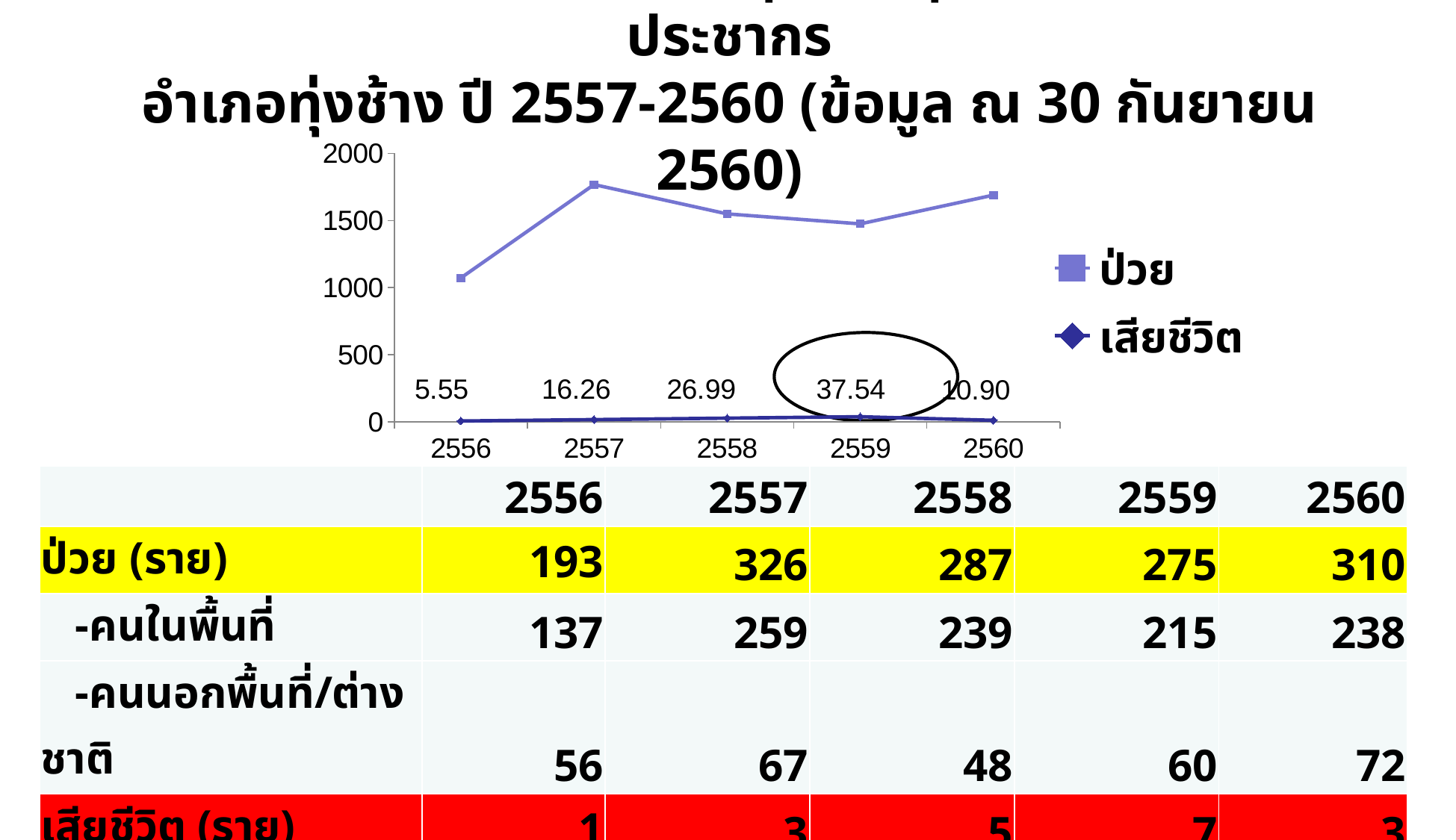
How many series does the legend list? 2 Is the value for ป่วย in 2557 greater or less than 1500? greater What is the difference between the เสียชีวิต values for 2559 and 2556? 31.99 In which year is the ป่วย value highest? 2557 What is the value for เสียชีวิต in 2559? 37.54 What is the value for เสียชีวิต in 2556? 5.55 What is the value for เสียชีวิต in 2558? 26.99 Is the value for ป่วย in 2556 greater or less than 1500? less Which is larger, the เสียชีวิต value for 2557 or for 2560? 2557 What kind of chart is shown on the slide? line chart In which year is the เสียชีวิต value highest? 2559 In which year is the เสียชีวิต value lowest? 2556